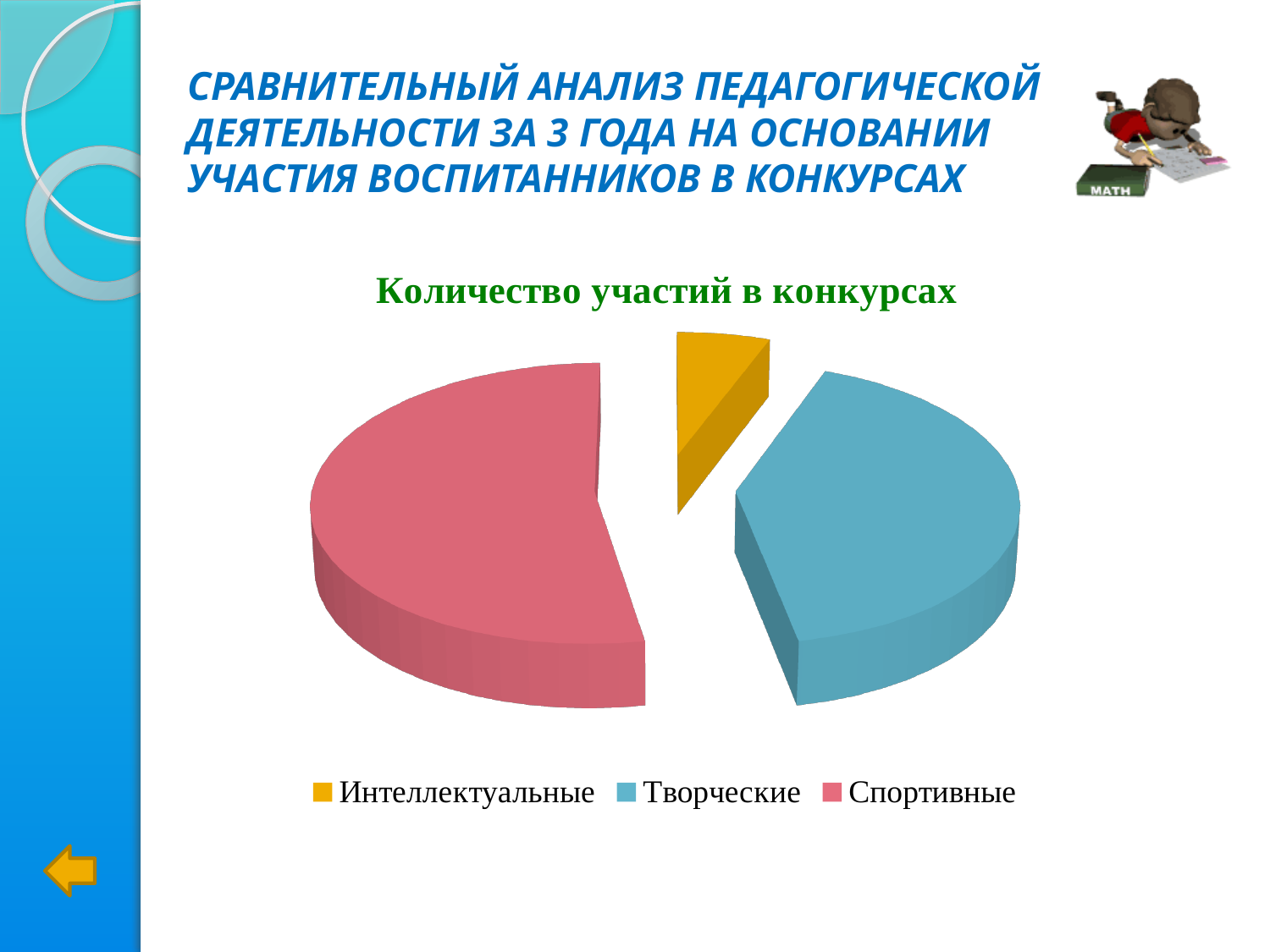
What is the title of the pie chart? Количество участий в конкурсах Which category has the largest slice in the pie chart? Спортивные Which slice is larger, Творческие or Интеллектуальные? Творческие What colour is the Творческие slice in the pie chart? blue What kind of chart is shown on the slide? pie chart Which slice is larger, Спортивные or Интеллектуальные? Спортивные Which category has the smallest slice in the pie chart? Интеллектуальные How many slices does the pie chart have? 3 How many entries does the legend of the pie chart list? 3